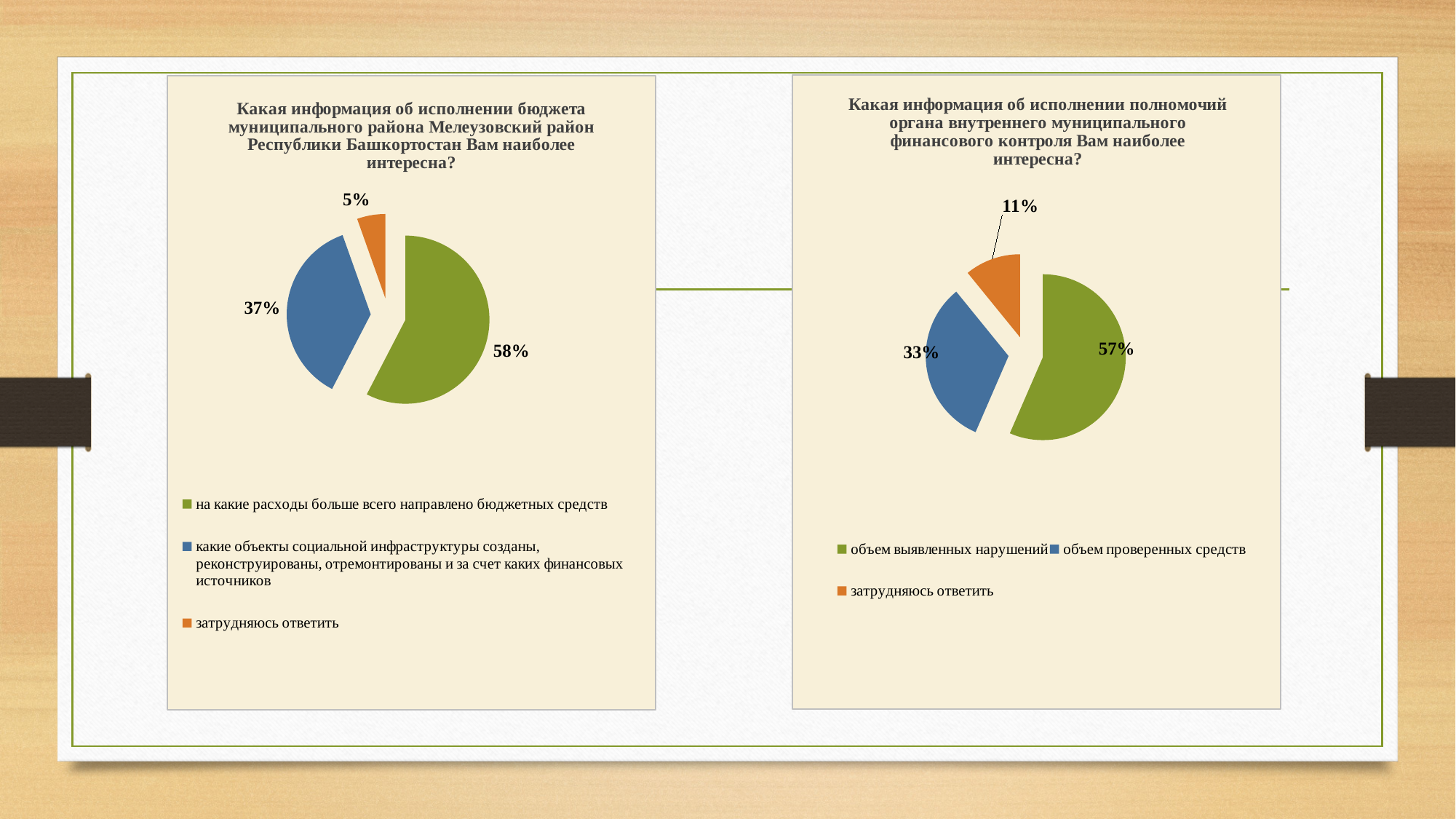
In the right pie chart, which is larger: "объем выявленных нарушений" or "объем проверенных средств"? объем выявленных нарушений In the right pie chart, which category has the smallest share? затрудняюсь ответить In the right pie chart, what is the difference between the shares for "объем выявленных нарушений" and "объем проверенных средств"? 24% How many slices does the left pie chart have? 3 In the left pie chart, what share of respondents chose "затрудняюсь ответить"? 5% In the right pie chart, what share is shown for "объем проверенных средств"? 33% What type of chart is used on the right side of the slide? Pie chart In the right pie chart, what share of respondents chose "затрудняюсь ответить"? 11% In the left pie chart, which category has the largest share? на какие расходы больше всего направлено бюджетных средств In the left pie chart, what share is shown for "на какие расходы больше всего направлено бюджетных средств"? 58% In the left pie chart, what is the difference between the largest and the smallest slice? 53% In the left pie chart, what colour is the slice for "затрудняюсь ответить"? Orange